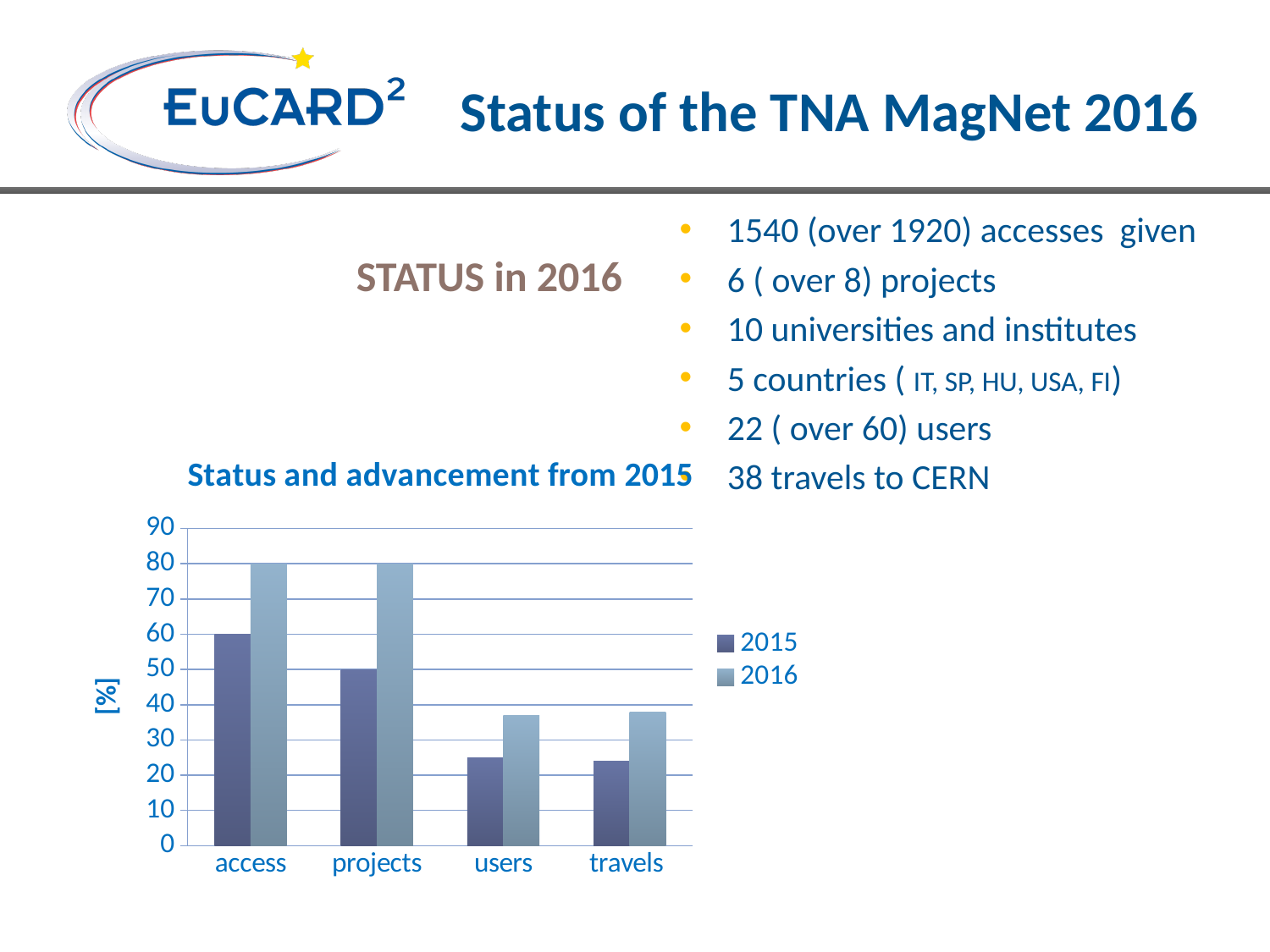
What is the 2016 value for access? 80 By how much did the value for projects increase from 2015 to 2016? 30 What is the 2015 value for projects? 50 Which category has the highest 2015 value? access What type of chart is shown on the slide? bar chart How many series does the chart legend list? 2 What is the 2015 value for access? 60 How many categories are shown on the x axis of the chart? 4 What is the title of the chart? Status and advancement from 2015 What is the 2016 value for projects? 80 Is the 2016 value for users greater or less than 30? greater Do the 2015 values rise or fall from access to travels along the x axis? fall